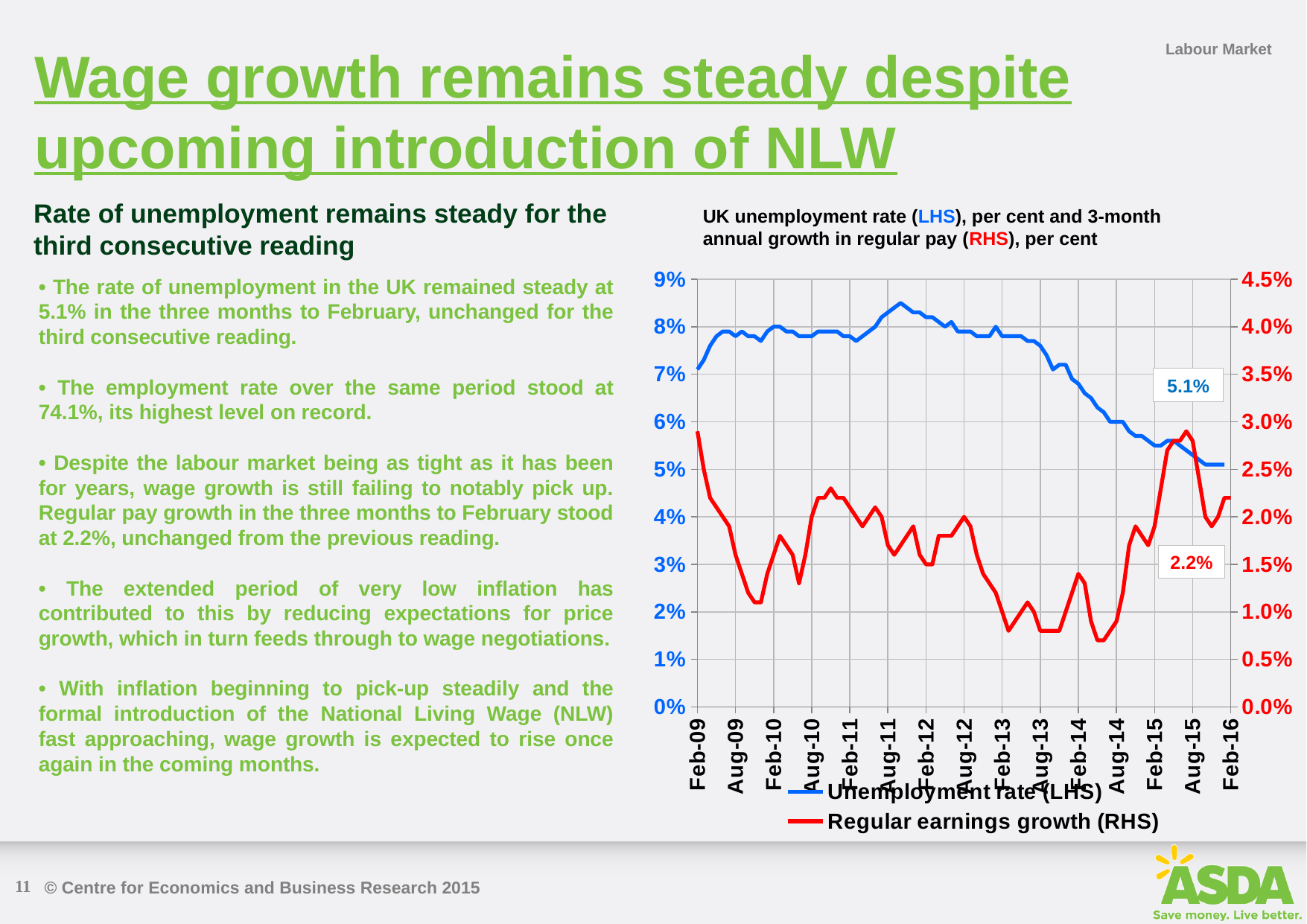
What is the labelled value of the unemployment rate (LHS) at Feb-16? 5.1% Is the unemployment rate at Feb-15 greater or less than 5%? greater Is the regular earnings growth at Feb-13 greater or less than 1.5%? less What is the labelled value of regular earnings growth (RHS) at Feb-16? 2.2% What kind of chart is shown on the slide? line chart Is the regular earnings growth at Feb-09 greater or less than 2.0%? greater What is the first date label on the x axis of the chart? Feb-09 What colour is the line for the unemployment rate (LHS)? blue Does the unemployment rate line rise or fall between Aug-11 and Feb-16? fall How many series does the chart's legend list? 2